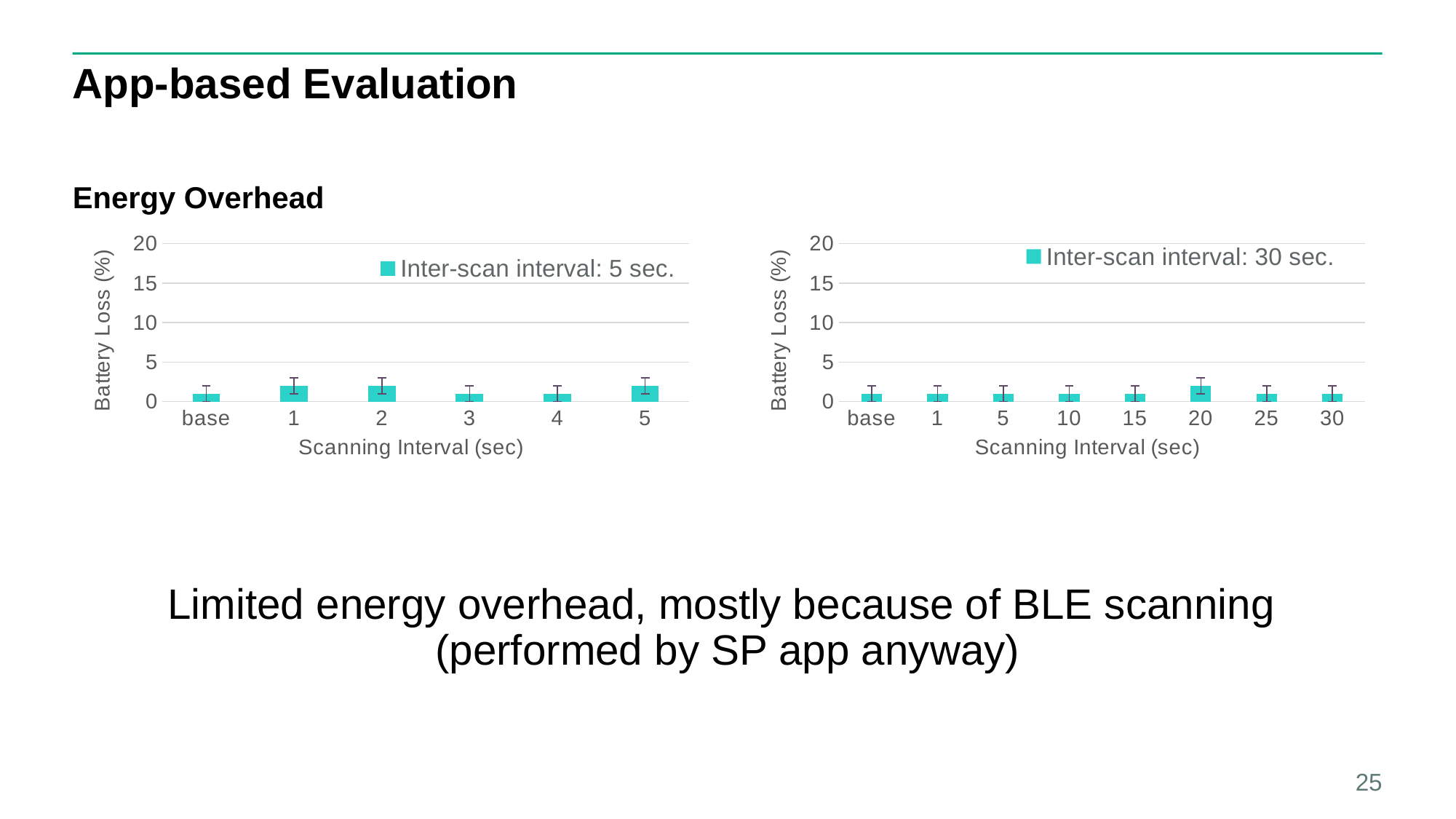
What is the legend entry of the left chart? Inter-scan interval: 5 sec. In the left chart (Inter-scan interval: 5 sec.), which is larger: the battery loss for scanning interval 2 or for scanning interval 3? 2 What is the y-axis title of the right chart (Inter-scan interval: 30 sec.)? Battery Loss (%) How many series does the legend of the right chart (Inter-scan interval: 30 sec.) list? 1 How many scanning interval categories does the right chart (Inter-scan interval: 30 sec.) show? 8 What kind of chart is the left chart (Inter-scan interval: 5 sec.)? bar chart In the left chart (Inter-scan interval: 5 sec.), is the battery loss for scanning interval 2 greater or less than 5? less In the right chart (Inter-scan interval: 30 sec.), is the battery loss for scanning interval 20 greater or less than 5? less In the right chart (Inter-scan interval: 30 sec.), which scanning interval has the highest battery loss? 20 In the right chart (Inter-scan interval: 30 sec.), which is larger: the battery loss for scanning interval 20 or for scanning interval 25? 20 In the left chart (Inter-scan interval: 5 sec.), is the battery loss for base greater or less than 5? less How many scanning interval categories does the left chart (Inter-scan interval: 5 sec.) show? 6